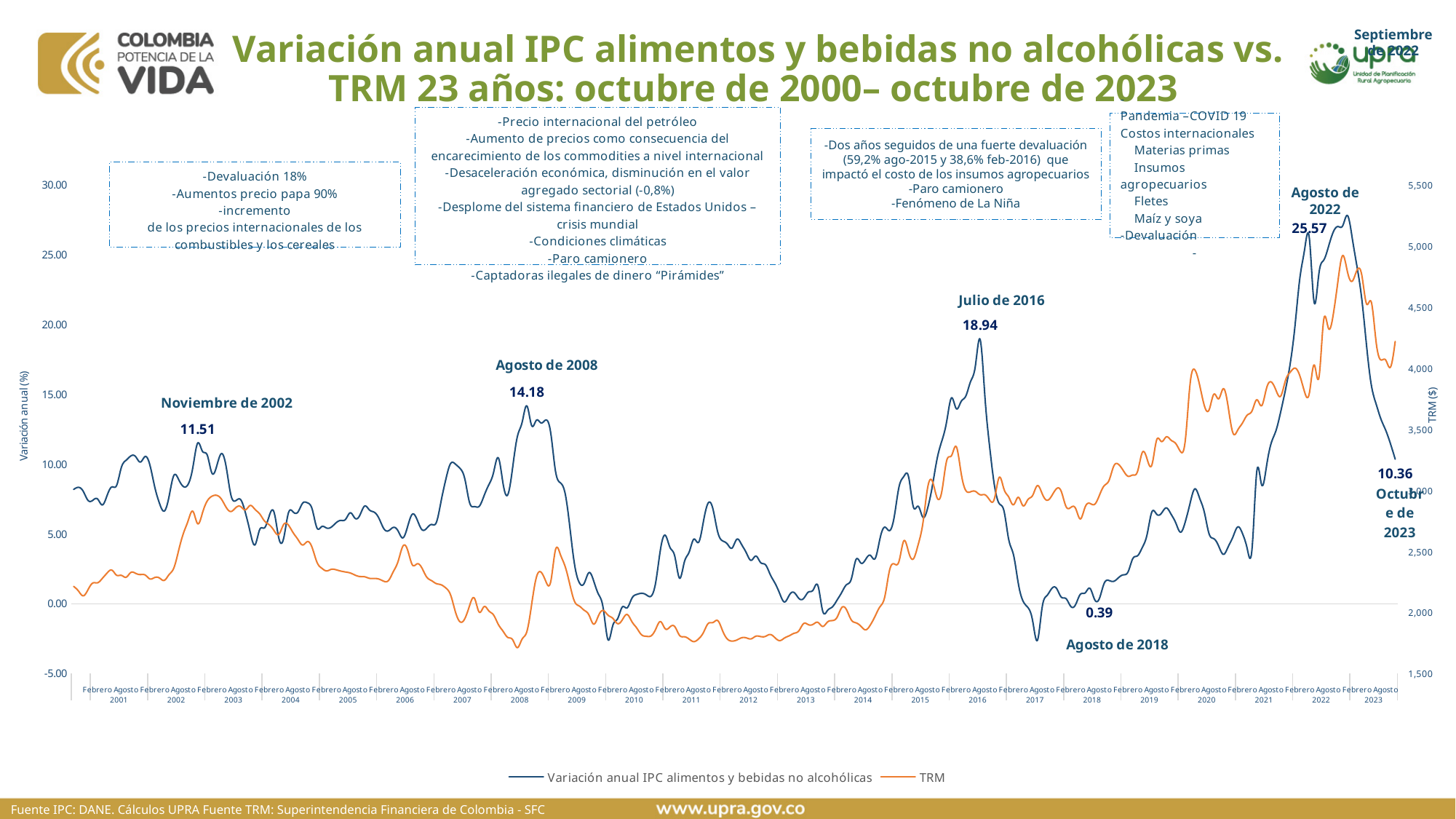
What kind of chart is shown on the slide? Line chart How many series does the legend list? 2 What value is labelled for Noviembre de 2002 on the IPC line? 11.51 What value is labelled for Julio de 2016 on the IPC line? 18.94 Which labelled point on the IPC line has the highest value? Agosto de 2022 What is the labelled value of the annual food and non-alcoholic beverages CPI variation in Agosto de 2022? 25.57 Which labelled point on the IPC line has the lowest value? Agosto de 2018 What value is labelled for Agosto de 2018 on the IPC line? 0.39 What is the difference between the labelled IPC values for Agosto de 2022 and Julio de 2016? 6.63 What value is labelled for Agosto de 2008 on the IPC line? 14.18 What value is labelled for Octubre de 2023 on the IPC line? 10.36 Which labelled IPC value is larger: Julio de 2016 or Agosto de 2008? Julio de 2016